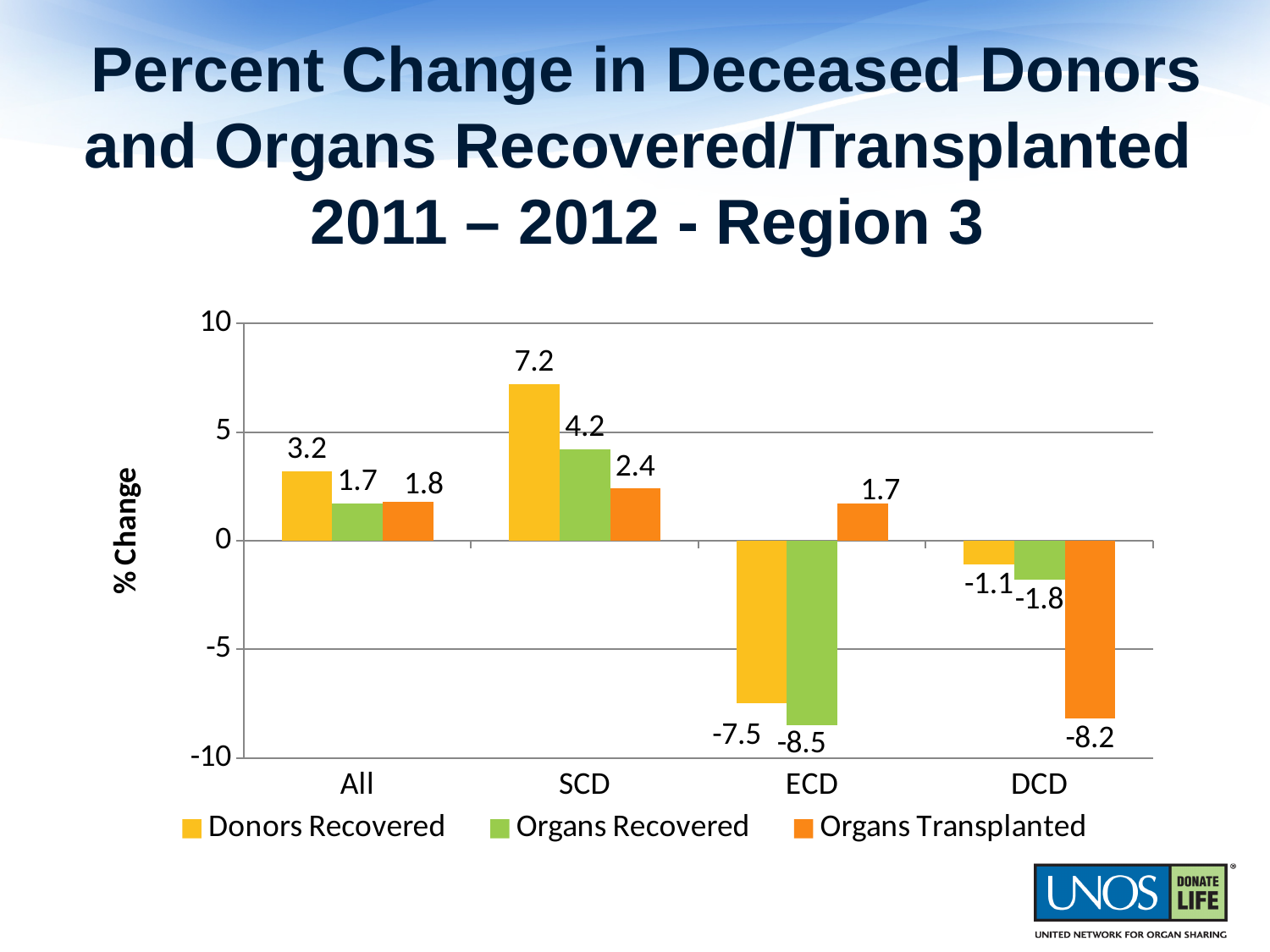
How many categories are shown on the x axis? 4 What is the difference between the Donors Recovered value for SCD and the Donors Recovered value for All? 4.0 What is the value for Donors Recovered in the SCD category? 7.2 Which is larger in the ECD category: Donors Recovered or Organs Recovered? Donors Recovered What is the value for Organs Recovered in the DCD category? -1.8 Which category has the lowest value for Organs Transplanted? DCD What kind of chart is shown on the slide? bar chart What is the label of the y axis? % Change Which category has the highest value for Donors Recovered? SCD What is the value for Organs Transplanted in the ECD category? 1.7 How many series does the legend list? 3 Is the value for Organs Transplanted in the DCD category greater or less than -5? less